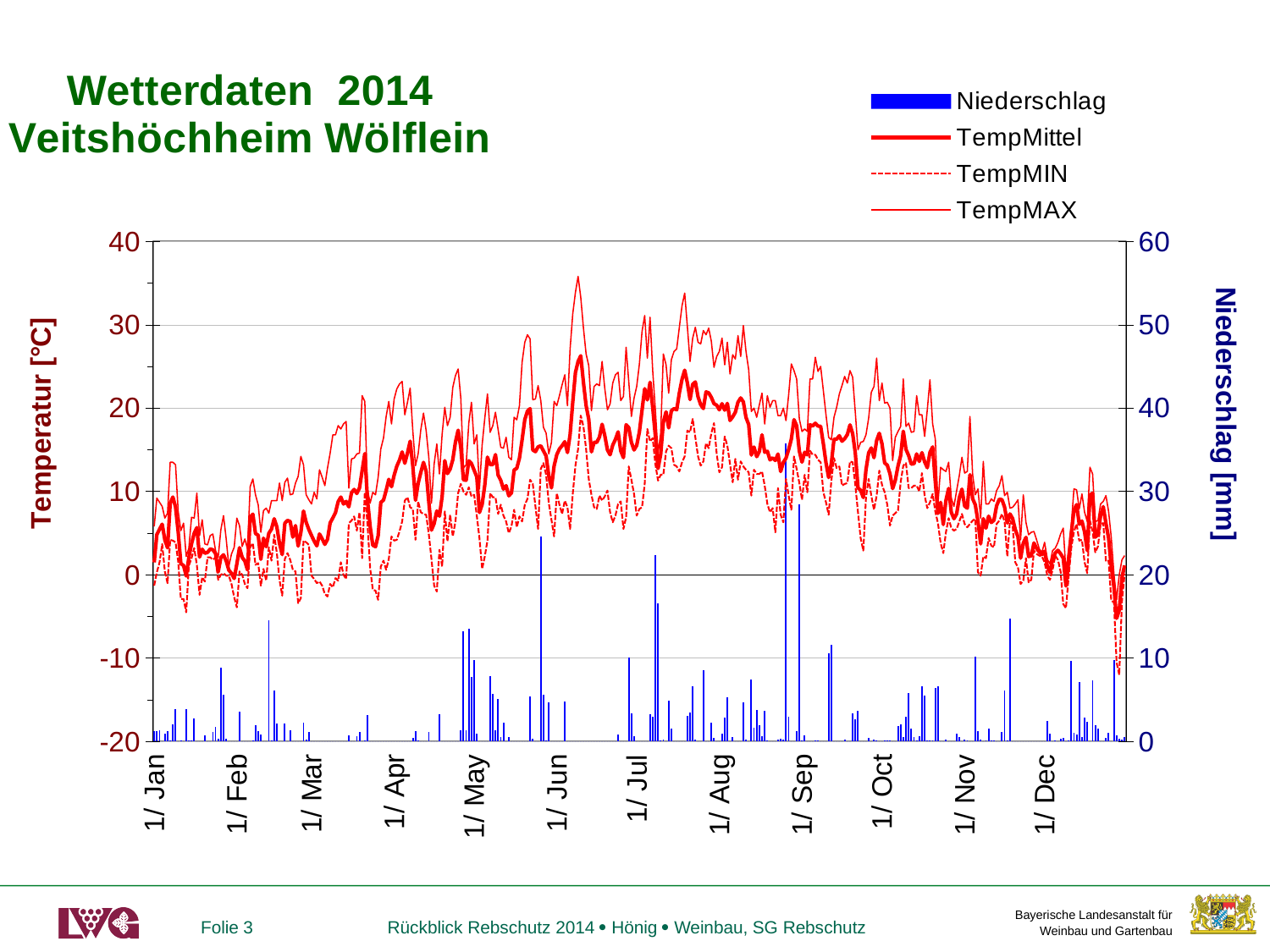
What kind of chart is shown on the slide? A combined bar and line chart Is the highest TempMAX value greater or less than 30? greater Is the TempMittel value at 1/Jan greater or less than 10? less How many month labels are shown on the x axis? 12 Which series is plotted as bars? Niederschlag Does the TempMittel line generally rise or fall from 1/Jan to 1/Jul? rise Is the TempMittel value at 1/Dec greater or less than 10? less How many series does the legend list? 4 Does the TempMittel line generally rise or fall from 1/Aug to 1/Dec? fall What is the title of the chart? Wetterdaten 2014 Veitshöchheim Wölflein